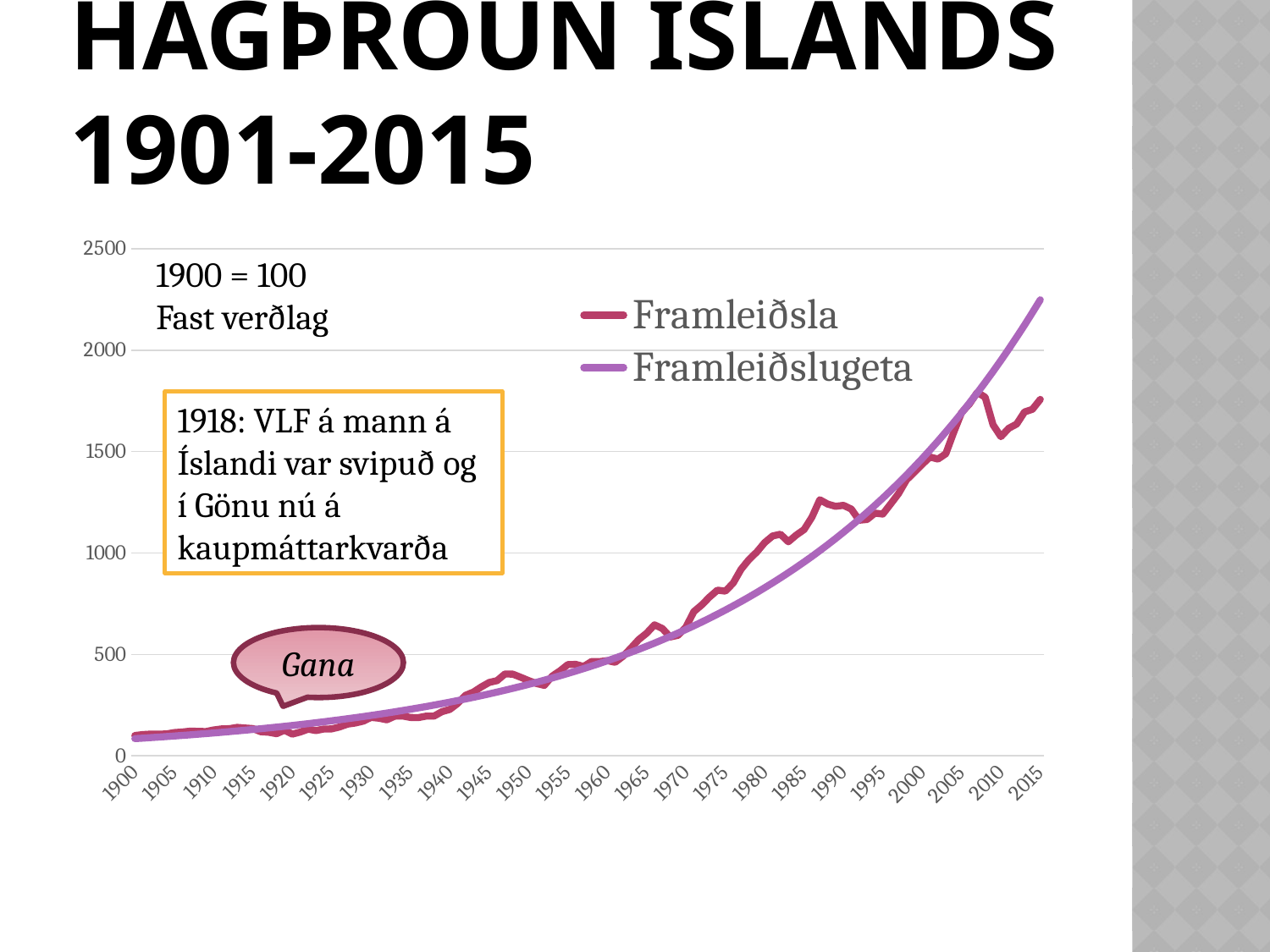
Is the value of Framleiðsla in 1950 greater or less than 500? less Is the value of Framleiðsla in 2015 greater or less than 2000? less How many series does the legend list? 2 What is the title of the slide containing the chart? HAGÞRÓUN ÍSLANDS 1901-2015 Is the value of Framleiðslugeta in 2015 greater or less than 2000? greater What kind of chart is shown on the slide? line chart How many year labels are shown on the x axis? 24 What are the two series named in the legend? Framleiðsla and Framleiðslugeta In 1985, which series has the higher value, Framleiðsla or Framleiðslugeta? Framleiðsla In 2015, which series has the higher value, Framleiðsla or Framleiðslugeta? Framleiðslugeta Does the Framleiðslugeta line rise or fall from 1900 to 2015? rise